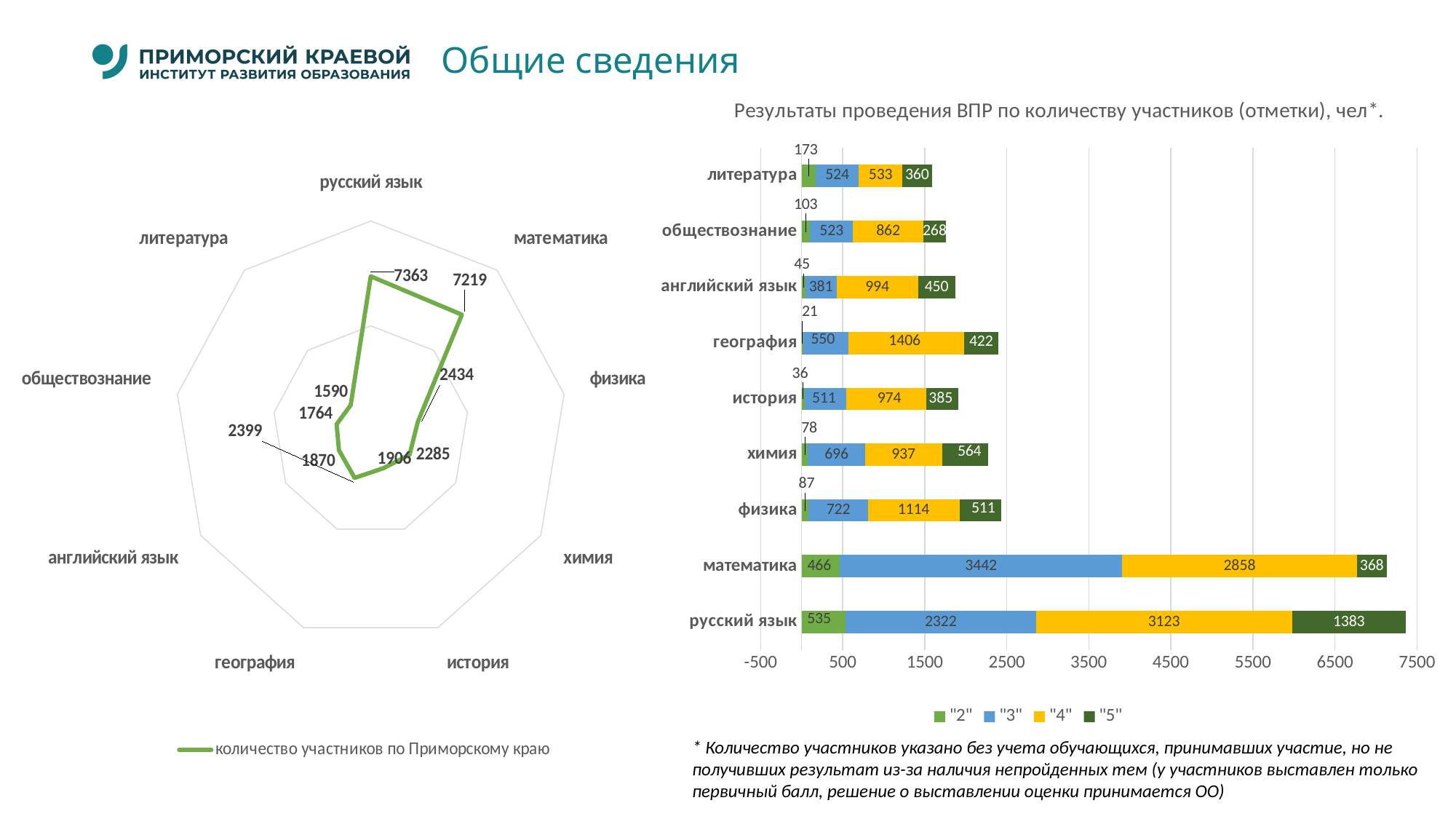
In the bar chart on the right, how many participants received a "3" in физика? 722 In the bar chart on the right, how many series does the legend list? 4 What type of chart is shown on the left of the slide? radar chart In the bar chart on the right, which is larger: the number of "5" marks in химия or in история? химия In the bar chart on the right, how many subjects are shown? 9 In the bar chart on the right, how many participants received a "4" in математика? 2858 In the bar chart on the right, how many participants received a "2" in география? 21 In the bar chart on the right, what is the difference between the number of "4" marks and "3" marks in химия? 241 In the bar chart on the right, how many participants received a "5" in русский язык? 1383 In the radar chart on the left, what is the number of participants for русский язык? 7363 In the bar chart on the right, what is the total number of participants for литература (sum of all four marks)? 1590 In the bar chart on the right, which subject has the longest total bar? русский язык